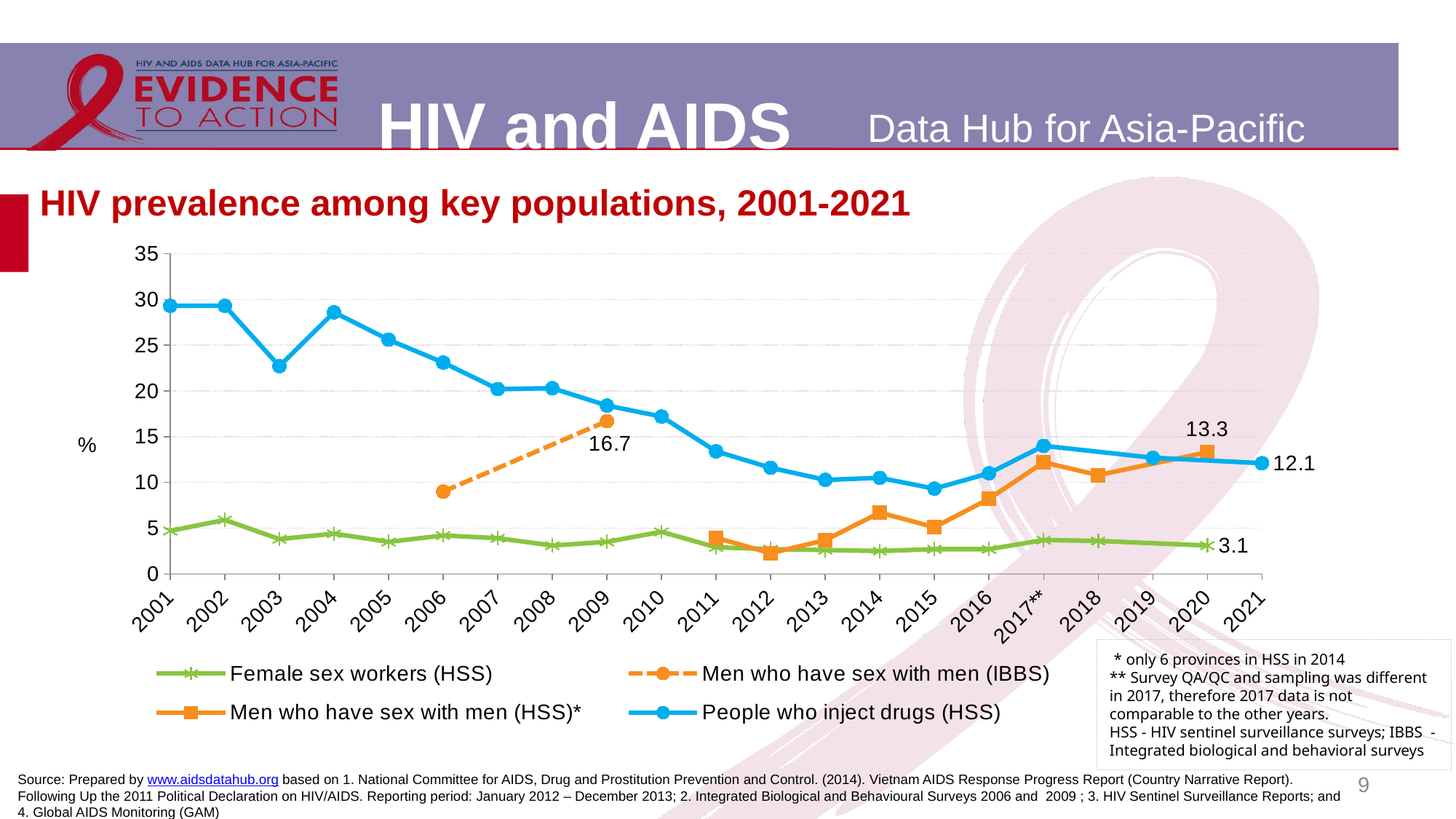
Does the HIV prevalence among people who inject drugs (HSS) rise or fall from 2001 to 2015? fall Which is larger: the 2020 value for men who have sex with men (HSS) or the 2021 value for people who inject drugs (HSS)? Men who have sex with men (HSS) in 2020 Is the value for people who inject drugs (HSS) in 2001 greater or less than 25? greater How many series does the legend list? 4 What is the HIV prevalence among people who inject drugs (HSS) in 2021? 12.1 What is the title of the chart? HIV prevalence among key populations, 2001-2021 What is the HIV prevalence among men who have sex with men (HSS) in 2020? 13.3 What is the HIV prevalence among men who have sex with men (IBBS) in 2009? 16.7 What kind of chart is shown on the slide? line chart How many years are shown on the x axis? 21